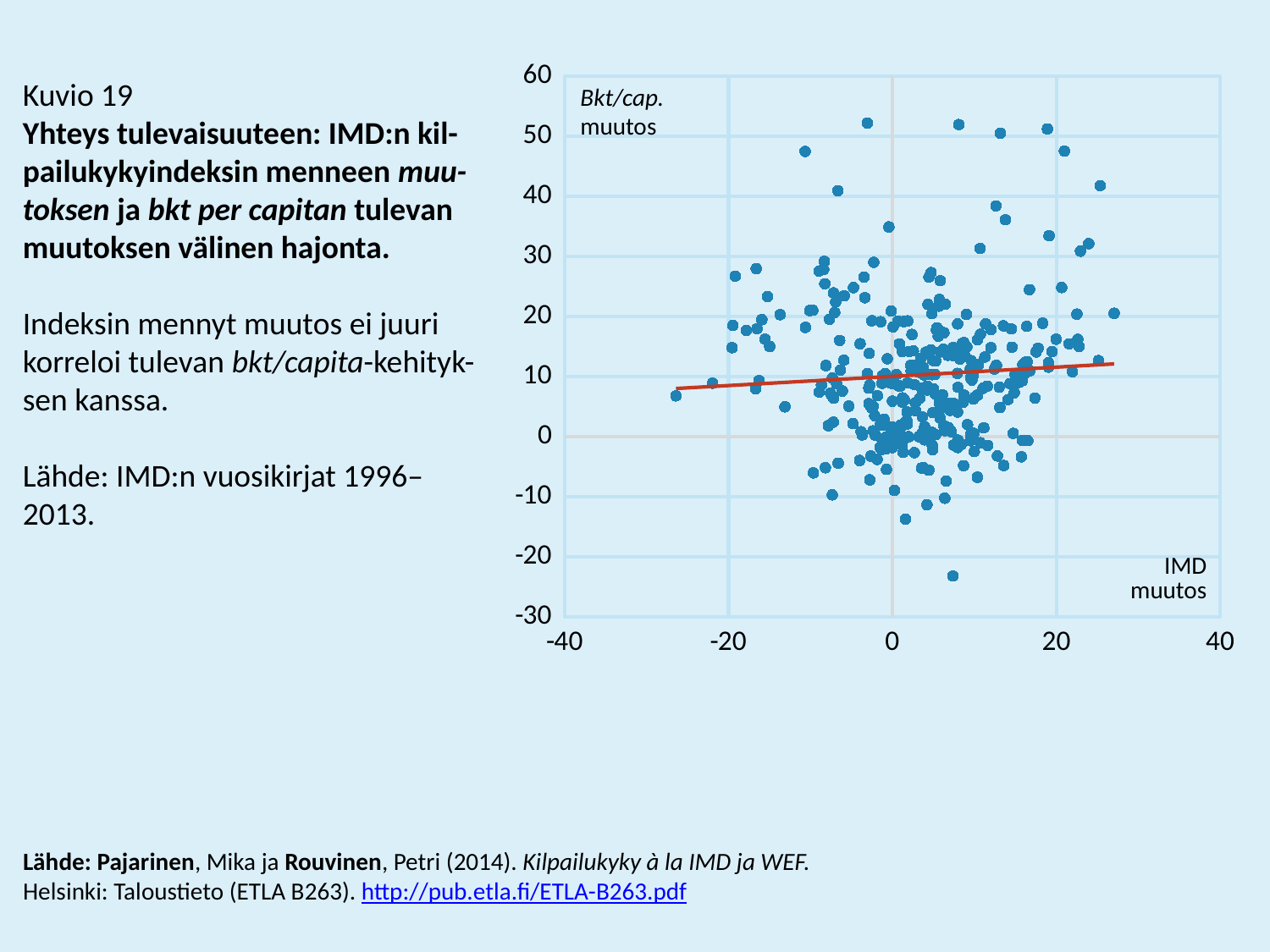
Is the Bkt/cap. muutos value of the red trend line at IMD muutos = 0 greater or less than 20? less What kind of chart is shown on the slide? scatter plot What is the label of the vertical axis of the chart? Bkt/cap. muutos Is the Bkt/cap. muutos value of the highest point in the chart greater or less than 50? greater What is the minimum value shown on the horizontal axis of the chart? -40 What is the label of the horizontal axis of the chart? IMD muutos Is the Bkt/cap. muutos value of the lowest point in the chart greater or less than -20? less Does the red trend line rise or fall as IMD muutos increases along the x axis? rises